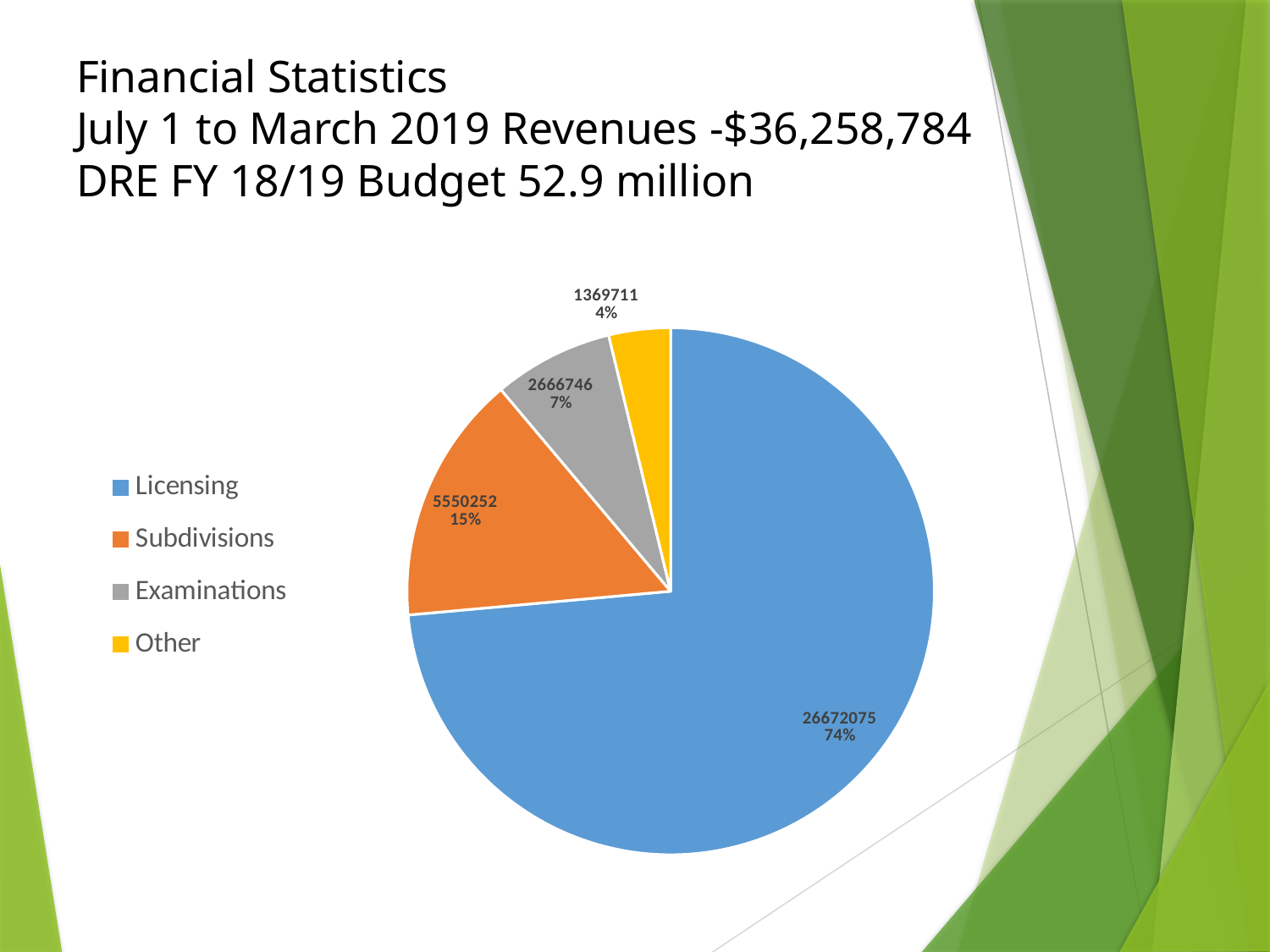
What is the value for Subdivisions? 5550252 How many categories does the legend list? 4 Which is larger, the value for Subdivisions or the value for Examinations? Subdivisions What share of the pie does Examinations represent? 7% What kind of chart is shown on the slide? pie chart Which category has the largest slice? Licensing What is the difference between the values for Examinations and Other? 1297035 Which category has the smallest slice? Other What is the value for Licensing? 26672075 What share of the pie does Subdivisions represent? 15% What is the value for Examinations? 2666746 What is the value for Other? 1369711